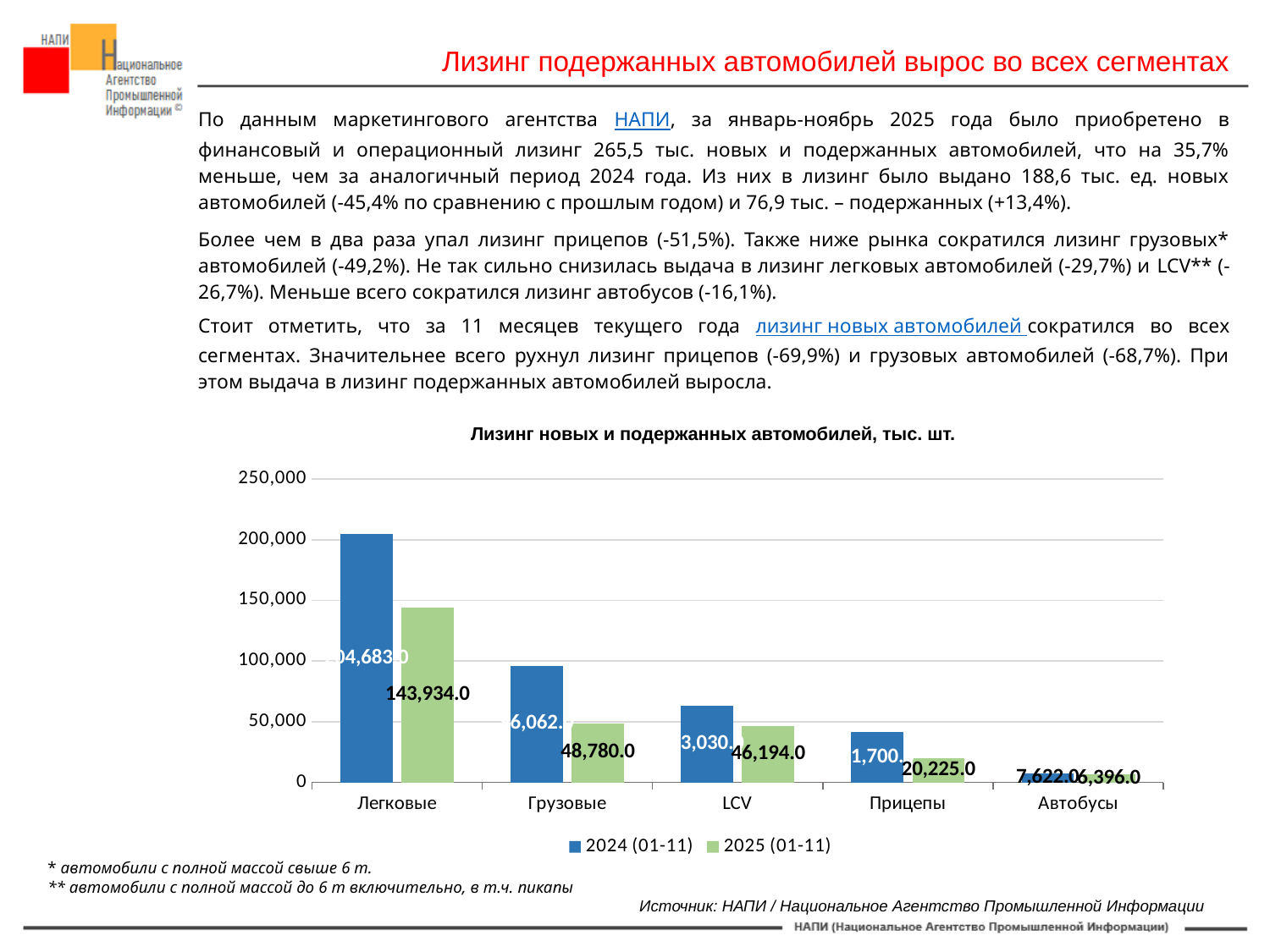
What is the value for LCV in the 2025 (01-11) series? 46,194.0 How many categories are shown on the x axis of the chart? 5 Which category has the highest value in the 2025 (01-11) series? Легковые What is the difference between the 2025 (01-11) values for Грузовые and LCV? 2,586.0 What is the value for Легковые in the 2025 (01-11) series? 143,934.0 Is the value for Легковые in the 2024 (01-11) series greater or less than 200,000? greater What is the value for Автобусы in the 2024 (01-11) series? 7,622.0 For Легковые, which series has the larger value, 2024 (01-11) or 2025 (01-11)? 2024 (01-11) How many series does the chart legend list? 2 Which category has the lowest value in the 2025 (01-11) series? Автобусы What is the value for Грузовые in the 2025 (01-11) series? 48,780.0 What is the value for Прицепы in the 2025 (01-11) series? 20,225.0